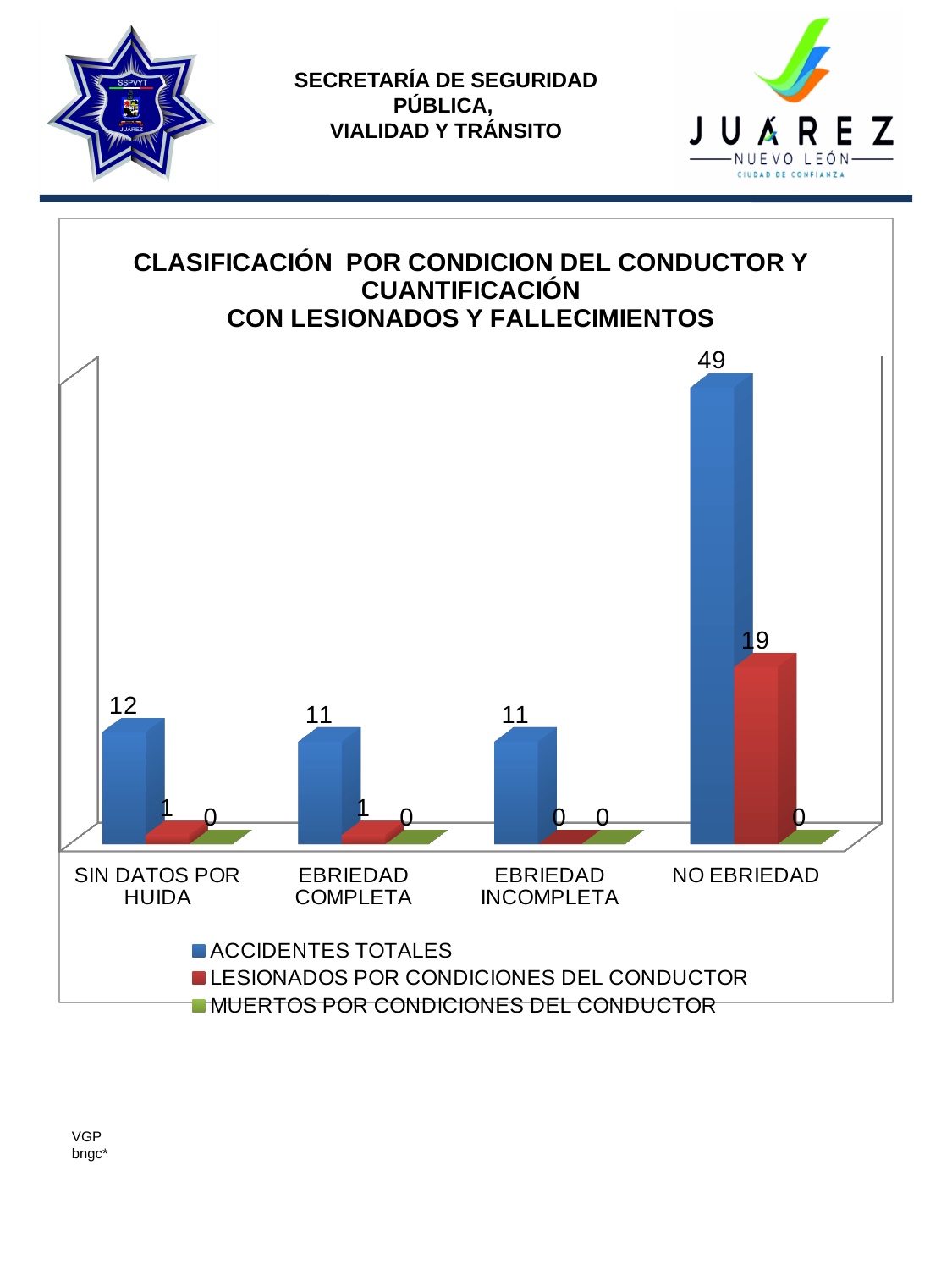
Which category has the highest value for ACCIDENTES TOTALES? NO EBRIEDAD What is the difference in ACCIDENTES TOTALES between NO EBRIEDAD and SIN DATOS POR HUIDA? 37 What kind of chart is shown on the slide? Bar chart What is the value of ACCIDENTES TOTALES for NO EBRIEDAD? 49 How many categories are shown on the x axis? 4 What is the value of LESIONADOS POR CONDICIONES DEL CONDUCTOR for EBRIEDAD COMPLETA? 1 Which is larger: ACCIDENTES TOTALES for SIN DATOS POR HUIDA or for EBRIEDAD COMPLETA? SIN DATOS POR HUIDA What is the difference between ACCIDENTES TOTALES and LESIONADOS POR CONDICIONES DEL CONDUCTOR for NO EBRIEDAD? 30 What colour represents MUERTOS POR CONDICIONES DEL CONDUCTOR in the legend? Green How many series does the legend list? 3 What is the value of LESIONADOS POR CONDICIONES DEL CONDUCTOR for NO EBRIEDAD? 19 What is the value of ACCIDENTES TOTALES for SIN DATOS POR HUIDA? 12